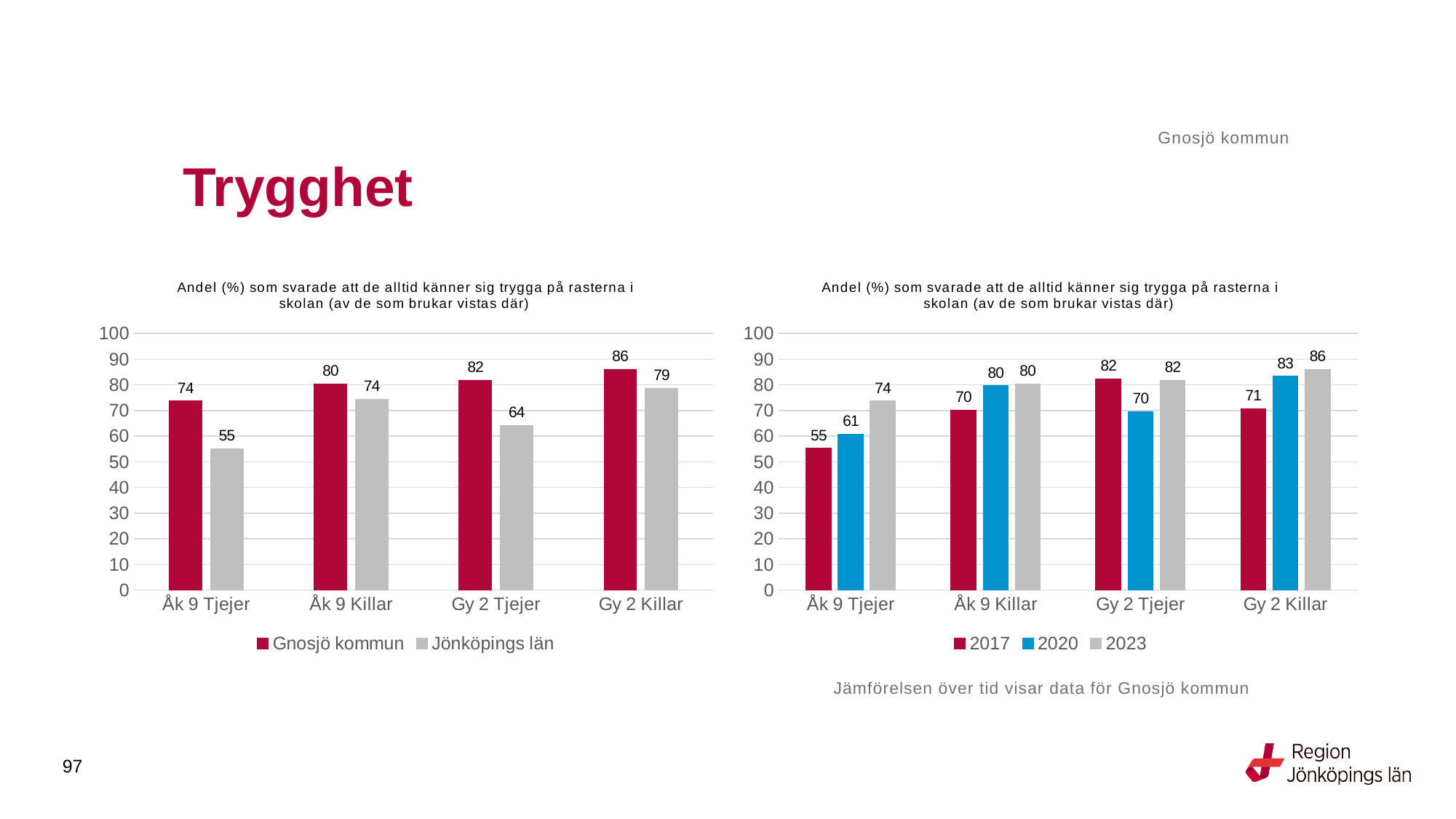
In the right chart, which is larger for Gy 2 Tjejer: the 2017 value or the 2020 value? 2017 In the right chart, what is the value for 2017 for Gy 2 Killar? 71 In the right chart, how many categories are shown on the x axis? 4 In the left chart, how many series does the legend list? 2 What kind of chart is the right chart? bar chart In the left chart, what is the value for Gnosjö kommun for Åk 9 Tjejer? 74 In the left chart, what is the difference between Gnosjö kommun and Jönköpings län for Åk 9 Tjejer? 19 In the right chart, what is the value for 2020 for Åk 9 Tjejer? 61 In the left chart, which category has the lowest value for Jönköpings län? Åk 9 Tjejer In the right chart, which category has the highest value for 2023? Gy 2 Killar In the left chart, do the Gnosjö kommun values rise or fall from Åk 9 Tjejer to Gy 2 Killar? rise In the left chart, what is the value for Jönköpings län for Gy 2 Tjejer? 64